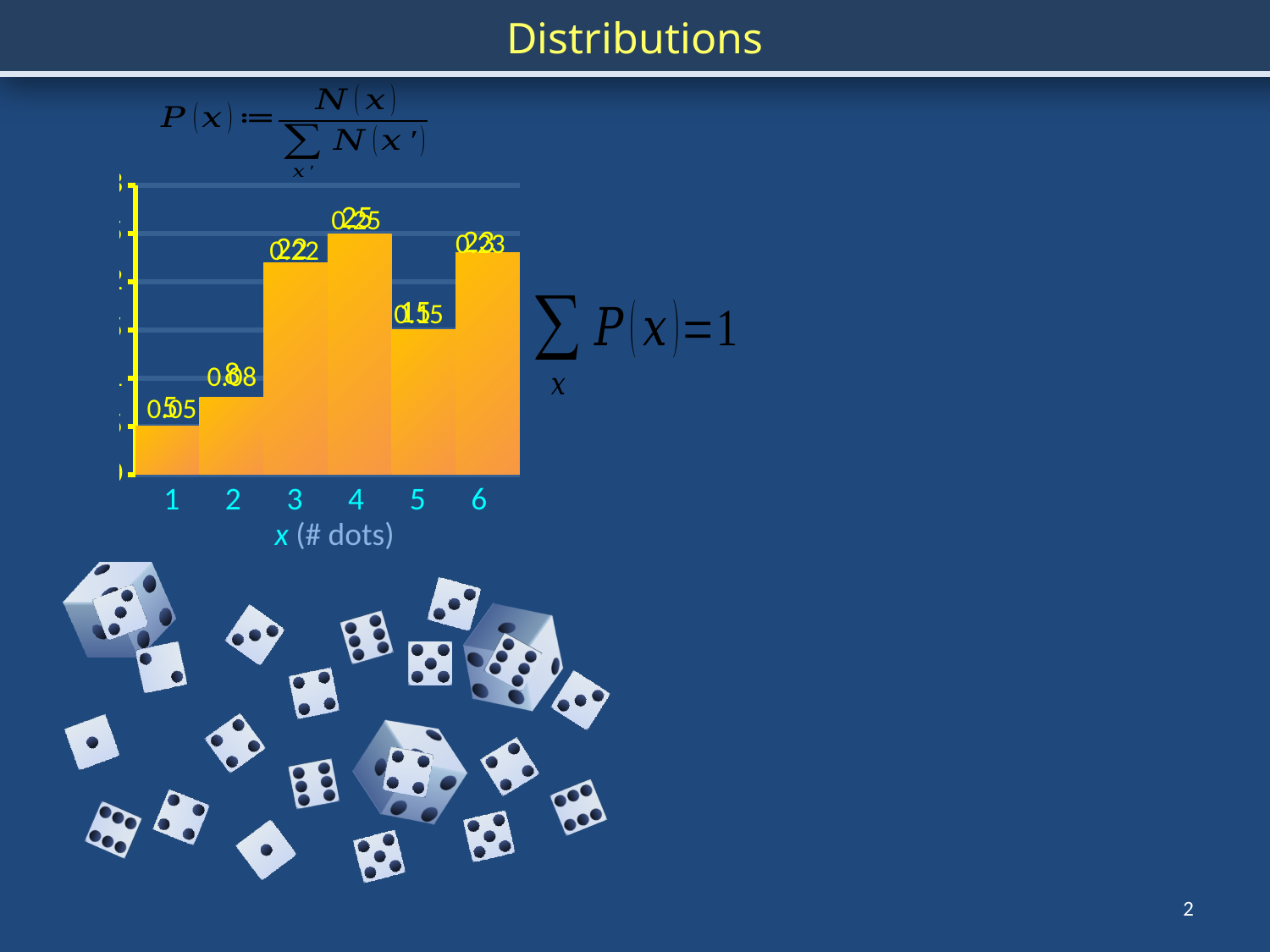
What kind of chart is shown on the slide? bar chart Which has the larger bar, x = 2 or x = 5? 5 Which x value has the highest bar in the chart? 4 Which has the larger bar, x = 5 or x = 6? 6 Which x value has the lowest bar in the chart? 1 What is the title of the slide containing the chart? Distributions Do the bar heights rise steadily from x = 1 to x = 6, or do they rise and then fluctuate? rise and then fluctuate How many categories are shown on the x axis of the chart? 6 Which has the larger bar, x = 1 or x = 2? 2 What is the label on the x axis of the chart? x (# dots)